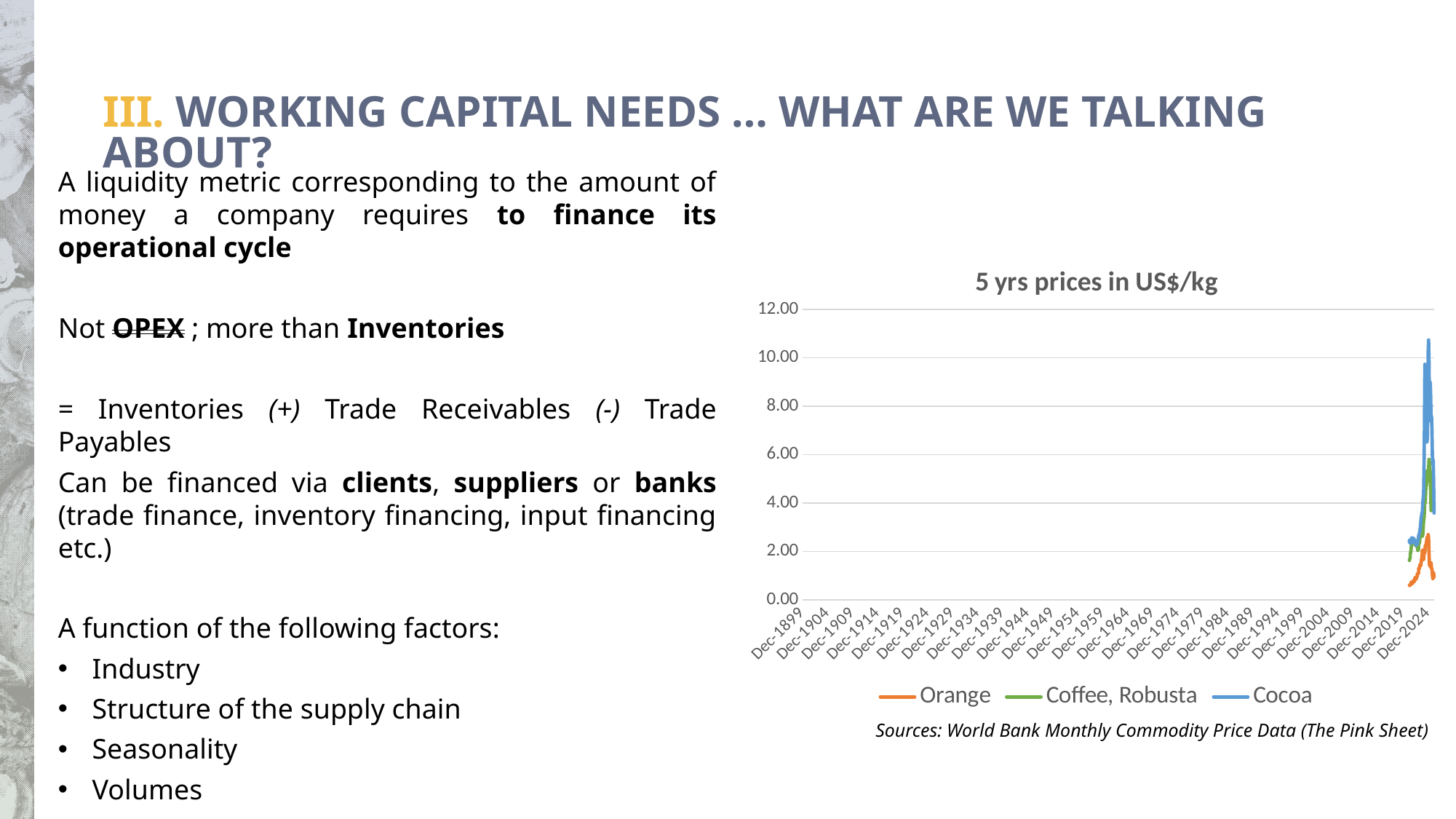
How many series does the chart's legend list? 3 What is the highest value shown on the chart's vertical axis? 12.00 Which series stays at the lowest prices on the chart? Orange Which series reaches the highest price on the chart? Cocoa Which series reaches a higher peak, Cocoa or Orange? Cocoa Is the peak value of the Cocoa series greater or less than 8.00? greater Is the peak value of the Orange series greater or less than 4.00? less What kind of chart is shown on the slide? Line chart What is the title of the chart? 5 yrs prices in US$/kg Which series are listed in the chart's legend? Orange, Coffee, Robusta, Cocoa Is the peak value of the Coffee, Robusta series greater or less than 8.00? less